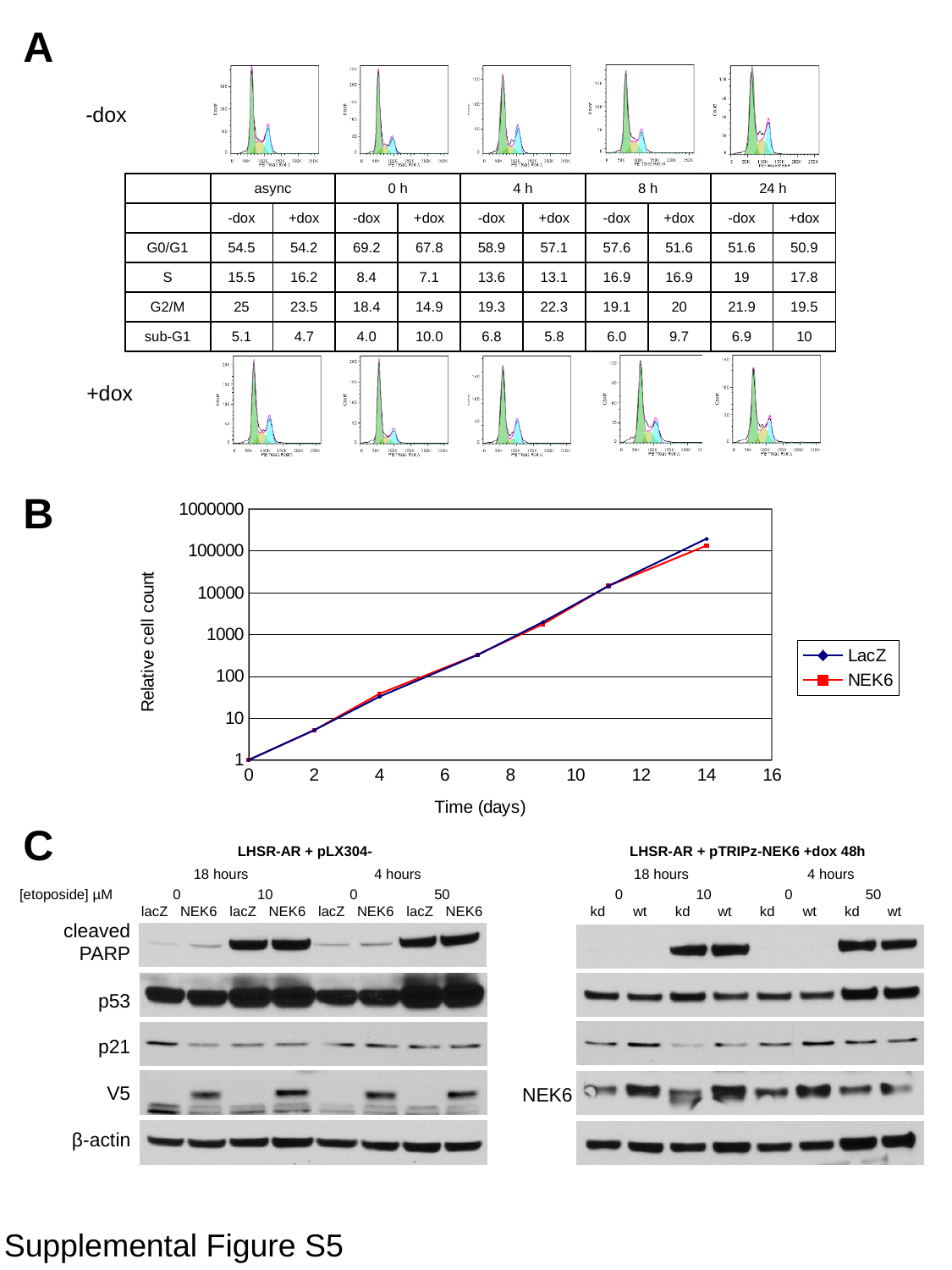
In the panel B chart, is the LacZ value at day 7 greater or less than 100? greater In the panel B chart, is the NEK6 value at day 11 greater or less than 10000? greater In the panel B chart, is the LacZ value at day 9 greater or less than 10000? less What is the y-axis label of the panel B chart? Relative cell count How many data points are plotted for each series in the panel B chart? 7 How many series does the legend of the panel B chart list? 2 In the panel B chart, which series has the higher value at day 14, LacZ or NEK6? LacZ What kind of chart is shown in panel B? line chart What are the two series named in the legend of the panel B chart? LacZ and NEK6 In the panel B chart, do the relative cell counts rise or fall as time increases? rise